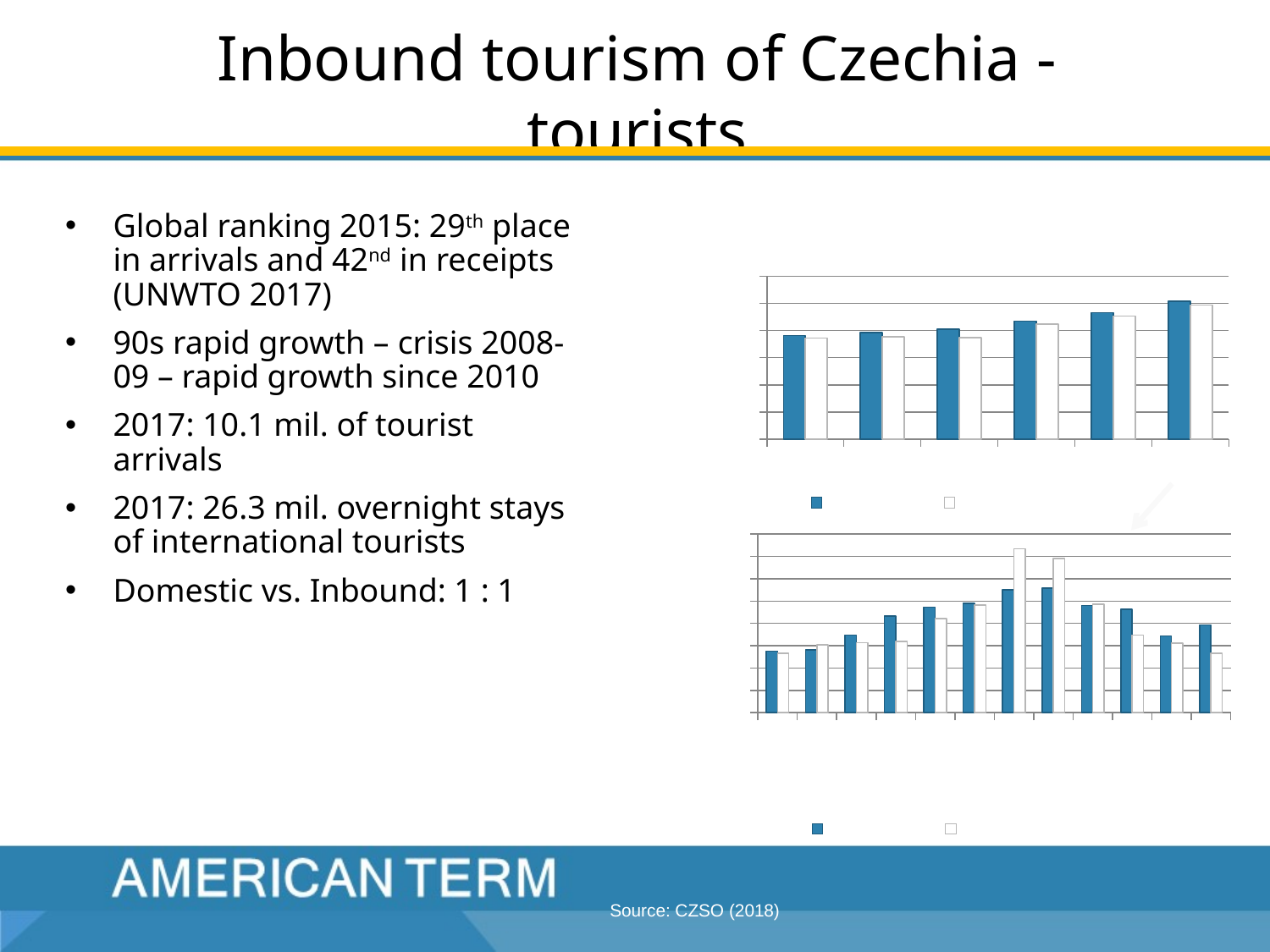
In the lower chart, which group of bars from the left contains the tallest bar? the seventh group In the lower chart, how many groups of bars are plotted along the x axis? 12 What kind of chart is the lower chart on the right of the slide? bar chart In the upper chart, how many groups of bars are plotted along the x axis? 6 In the upper chart, do the bar values rise or fall from left to right along the x axis? rise How many series does the legend of the upper chart list? 2 What source is cited for the charts at the bottom of the slide? CZSO (2018) What kind of chart is the upper chart on the right of the slide? bar chart How many series does the legend of the lower chart list? 2 What two colours are used for the bar series in the charts? blue and white In the upper chart, which group of bars is taller: the leftmost group or the rightmost group? the rightmost group In the lower chart, which group of bars from the left is the shortest? the first group